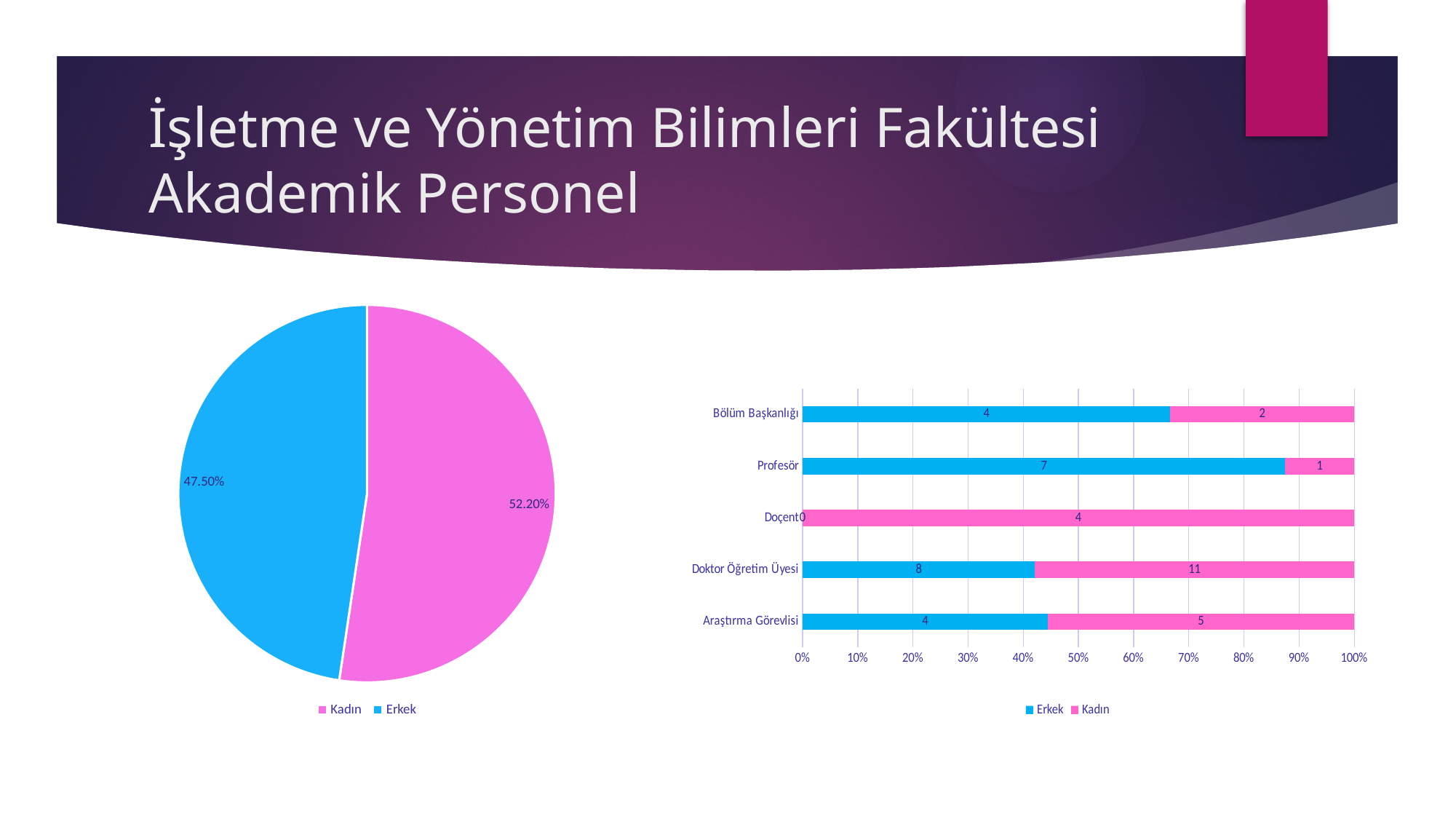
In the pie chart on the left, what share is shown for Kadın? 52.20% In the bar chart on the right, how many series does the legend list? 2 In the bar chart on the right, what is the Erkek value for Doçent? 0 In the bar chart on the right, what is the difference between the Kadın and Erkek values for Doktor Öğretim Üyesi? 3 In the bar chart on the right, what is the total of the Erkek and Kadın values for Araştırma Görevlisi? 9 What kind of chart is the chart on the right of the slide? Bar chart What kind of chart is the chart on the left of the slide? Pie chart In the pie chart on the left, which slice is larger, Kadın or Erkek? Kadın In the bar chart on the right, how many categories are shown on the vertical axis? 5 In the bar chart on the right, what is the Erkek value for Profesör? 7 In the bar chart on the right, what is the Kadın value for Doktor Öğretim Üyesi? 11 In the pie chart on the left, what share is shown for Erkek? 47.50%